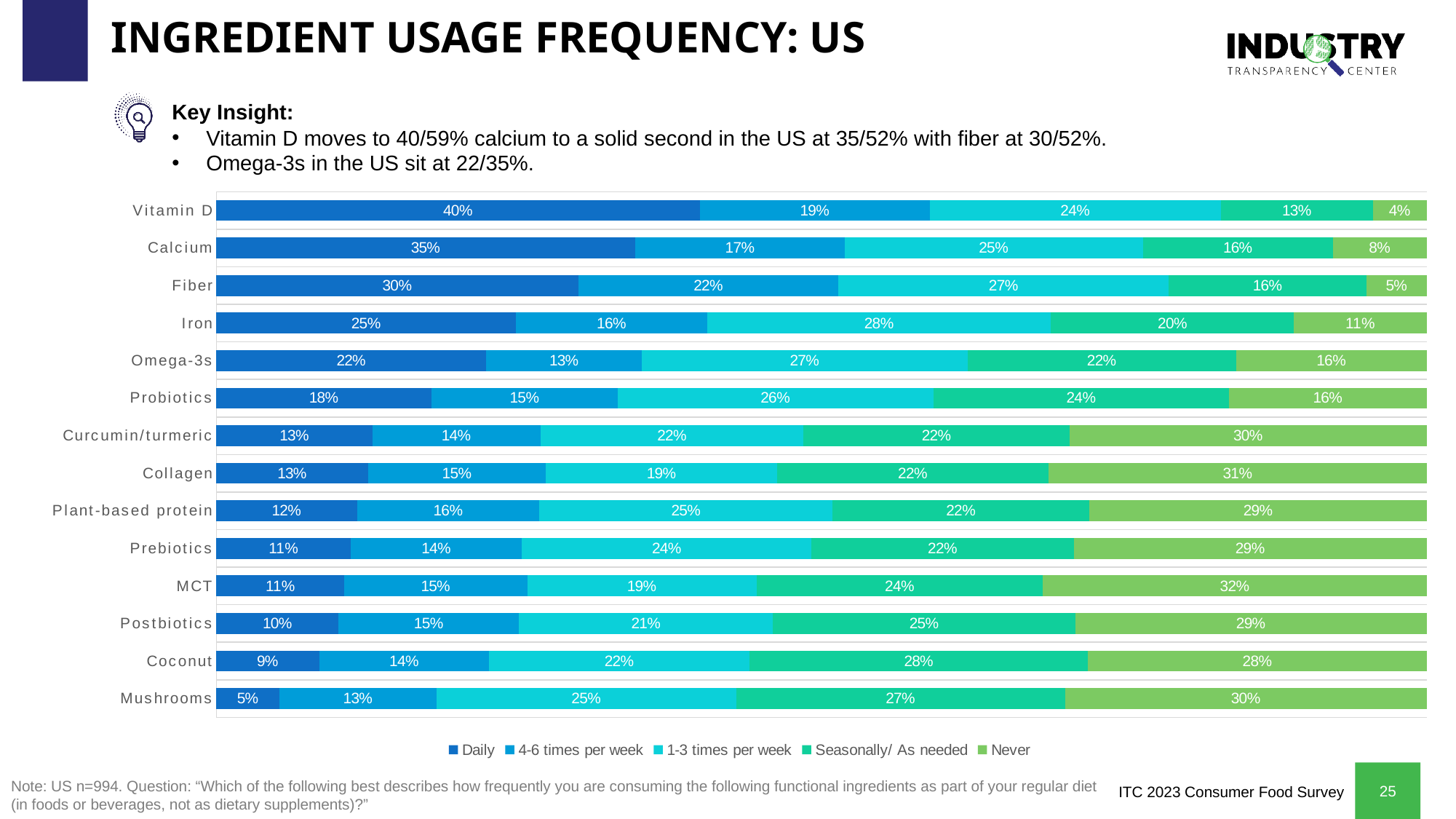
How many ingredients are shown in the chart? 14 Which is larger, the Daily value for Fiber or the Daily value for Iron? Fiber What is the Daily value for Vitamin D? 40% What is the total of the stacked bar for Vitamin D? 100% How many series does the legend list? 5 Which ingredient has the highest Never value? MCT Which ingredient has the lowest Daily value? Mushrooms What is the Never value for Collagen? 31% Which ingredient has the highest Daily value? Vitamin D What is the difference between the Daily values for Vitamin D and Calcium? 5% What kind of chart is shown on the slide? Stacked bar chart What is the 1-3 times per week value for Iron? 28%